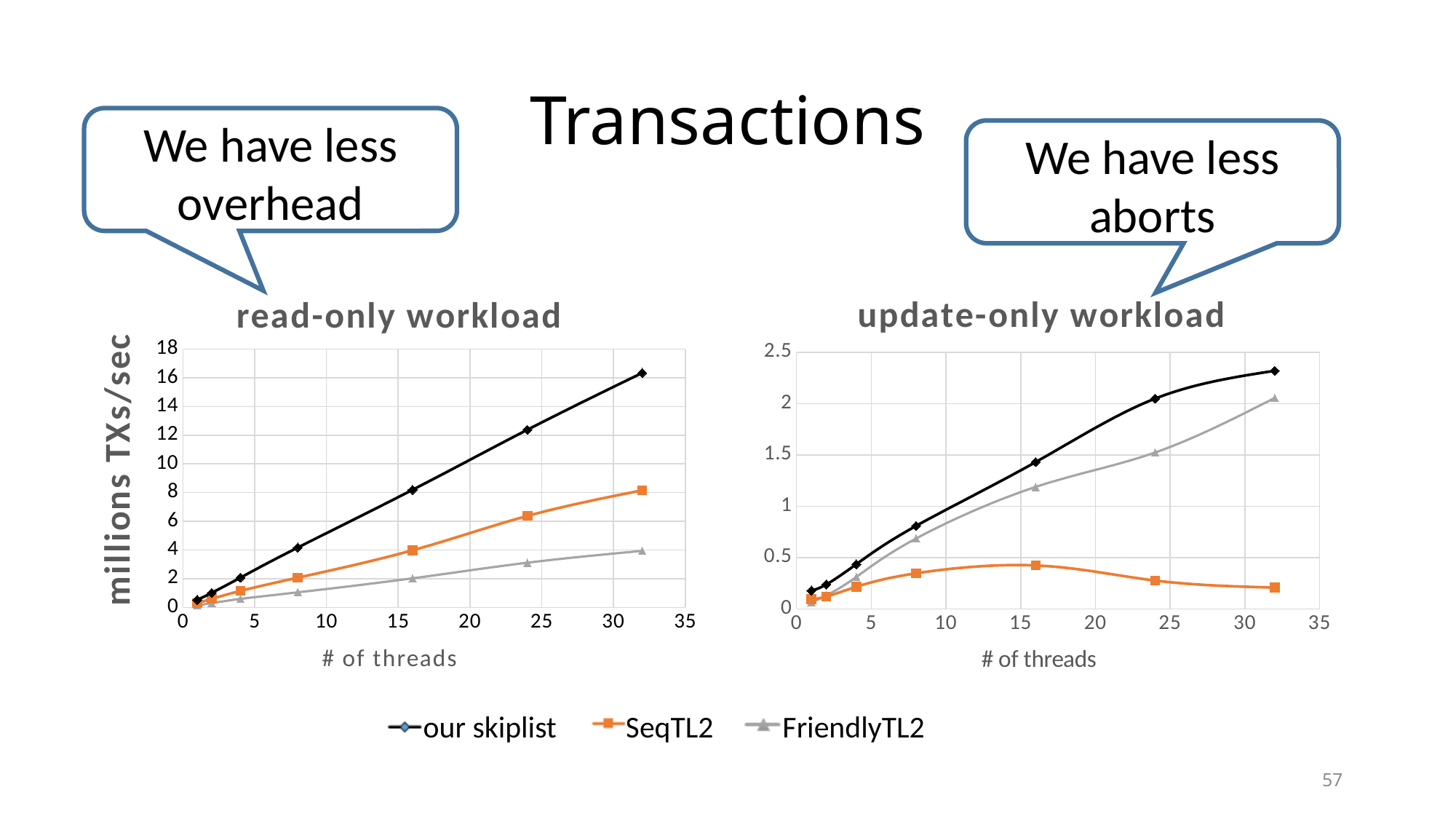
In the read-only workload chart, which series is highest at 32 threads? our skiplist In the read-only workload chart, how many data points does the our skiplist series have? 7 How many series does the legend list? 3 What is the y-axis label of the read-only workload chart? millions TXs/sec In the read-only workload chart, is the value for FriendlyTL2 at 32 threads greater or less than 6? less In the update-only workload chart, is the value for our skiplist at 32 threads greater or less than 2? greater In the update-only workload chart, is the value for SeqTL2 at 32 threads greater or less than 0.5? less What kind of chart is the read-only workload chart? line chart In the read-only workload chart, which series is lowest at 32 threads? FriendlyTL2 In the update-only workload chart, which series is lowest at 32 threads? SeqTL2 In the update-only workload chart, which is larger at 24 threads: our skiplist or FriendlyTL2? our skiplist